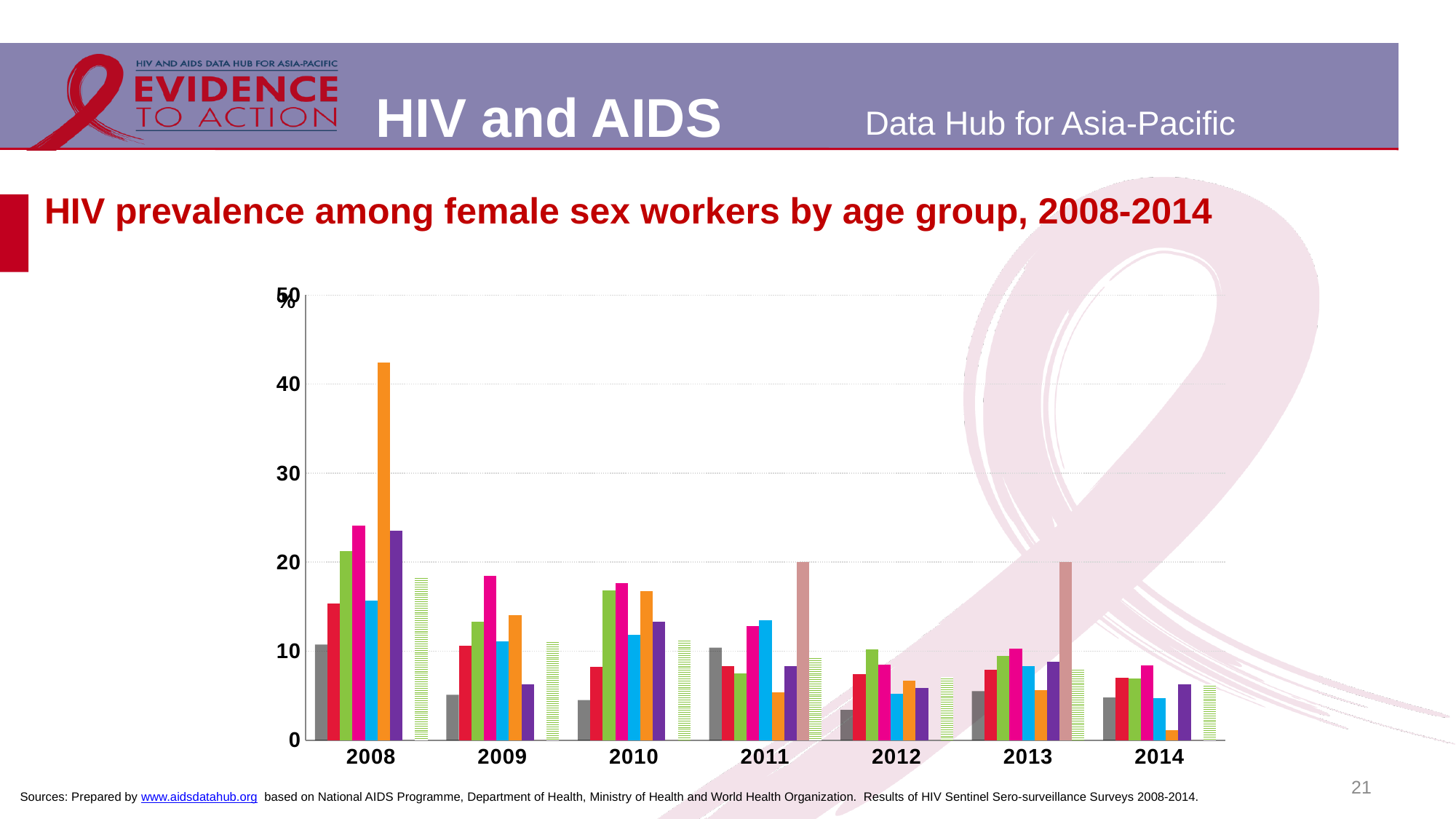
What is the highest value shown on the y axis of the chart? 50 Which year has the taller tallest bar, 2008 or 2014? 2008 Is the tallest bar in 2012 greater or less than 20? less What kind of chart is shown on the slide? bar chart Is the tallest bar in 2009 greater or less than 20? less Which year contains the tallest bar in the chart? 2008 Is the tallest bar in 2008 greater or less than 40? greater How many years are shown along the x axis of the chart? 7 What is the title of the chart on the slide? HIV prevalence among female sex workers by age group, 2008-2014 Which is the first year shown on the x axis of the chart? 2008